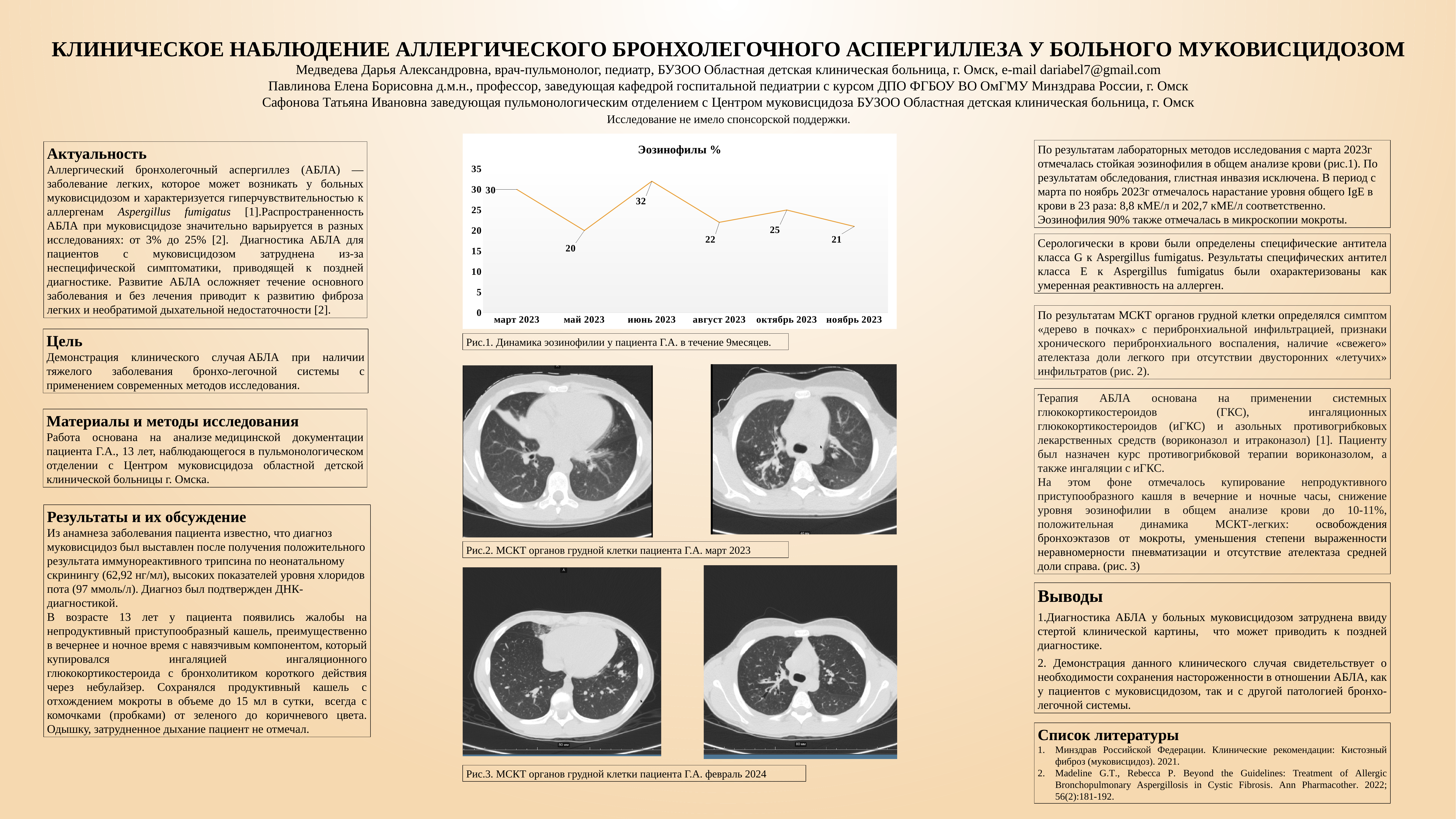
How many data points are plotted on the chart? 6 Which month has the highest value? июнь 2023 What type of chart is shown on the slide? line chart Which is larger, the value for октябрь 2023 or the value for август 2023? октябрь 2023 What is the difference between the values for июнь 2023 and май 2023? 12 Does the value rise or fall from март 2023 to май 2023? fall Is the value for март 2023 greater or less than 25? greater What is the title of the chart? Эозинофилы % What is the value for март 2023? 30 What is the value for июнь 2023? 32 Which month has the lowest value? май 2023 What is the value for ноябрь 2023? 21